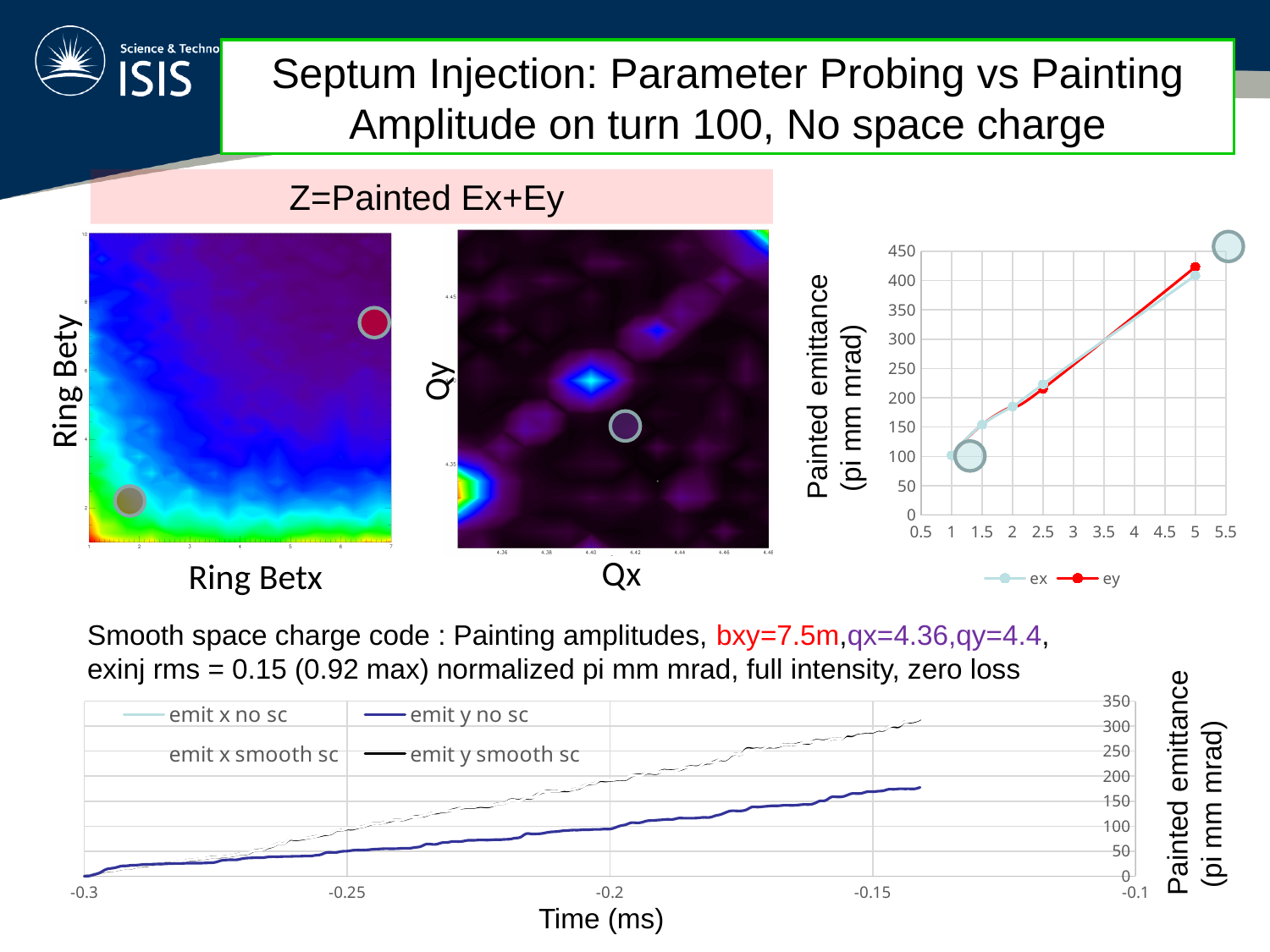
In the top-right chart with the ex and ey legend, do the values rise or fall as the x axis increases? rise In the bottom chart plotted against Time (ms), do the emittance values rise or fall as time increases? rise In the top-right chart with the ex and ey legend, what kind of chart is it? line chart In the top-right chart with the ex and ey legend, is the value of ex at x = 2.5 greater or less than 300? less In the top-right chart with the ex and ey legend, is the value of ex at x = 5 greater or less than 350? greater In the bottom chart plotted against Time (ms), how many series does the legend list? 4 In the top-right chart with the ex and ey legend, is the value of ey at x = 1 greater or less than 150? less In the top-right chart with the ex and ey legend, how many series does the legend list? 2 What is the x-axis label of the bottom chart? Time (ms) In the top-right chart with the ex and ey legend, how many data points are plotted for the ex series? 5